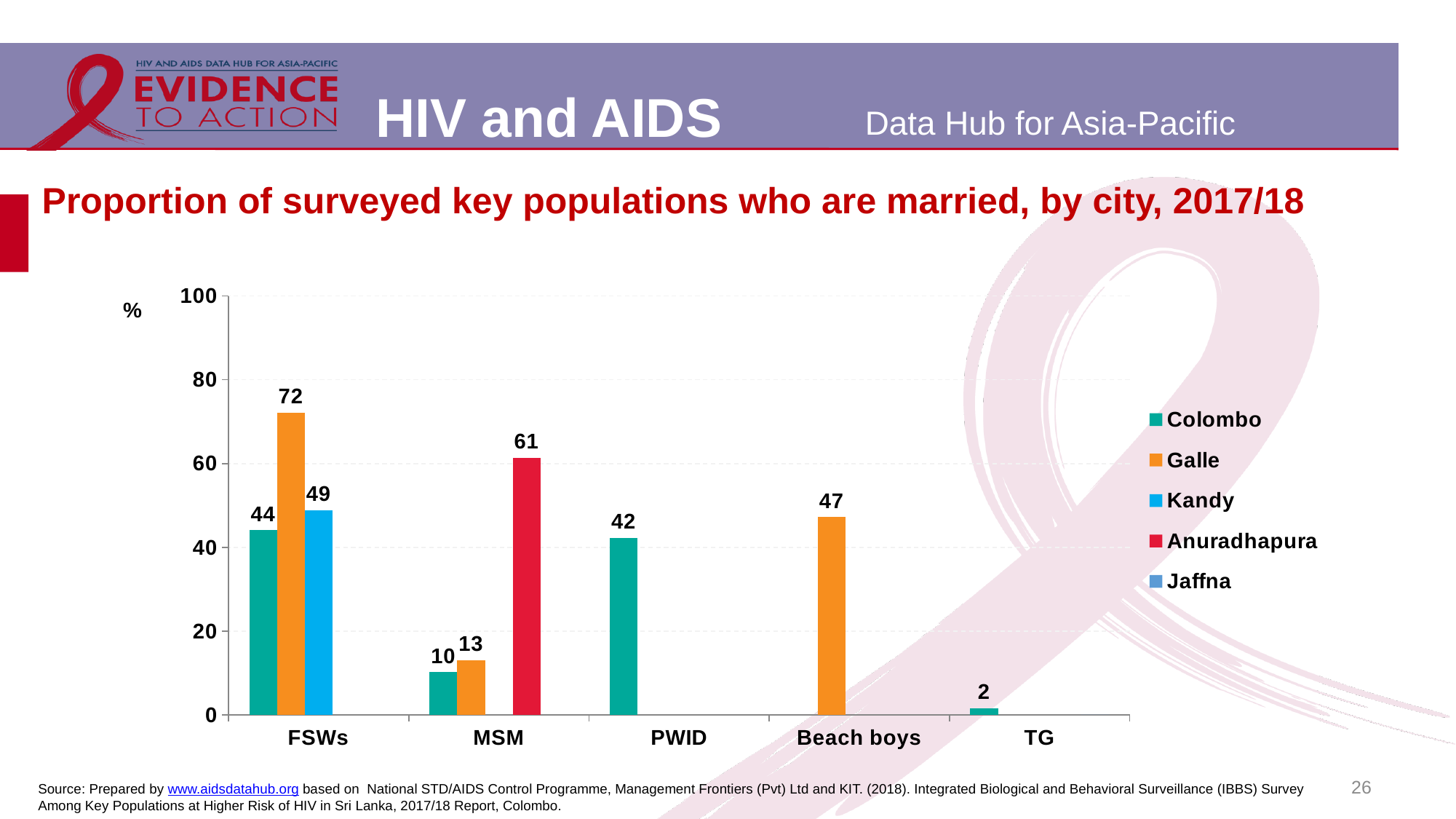
Which city has the lowest value among MSM? Colombo How many cities does the legend list? 5 Which is larger: the Kandy value among FSWs or the Galle value among Beach boys? Kandy value among FSWs Which city has the highest value among FSWs? Galle What kind of chart is shown on the slide? Bar chart How many key population categories are shown on the x axis? 5 What is the value for Colombo among PWID? 42 What is the value for Galle among FSWs? 72 What colour represents Anuradhapura in the chart? Red What is the value for Colombo among TG? 2 What is the value for Anuradhapura among MSM? 61 What is the difference between the Galle and Colombo values among FSWs? 28